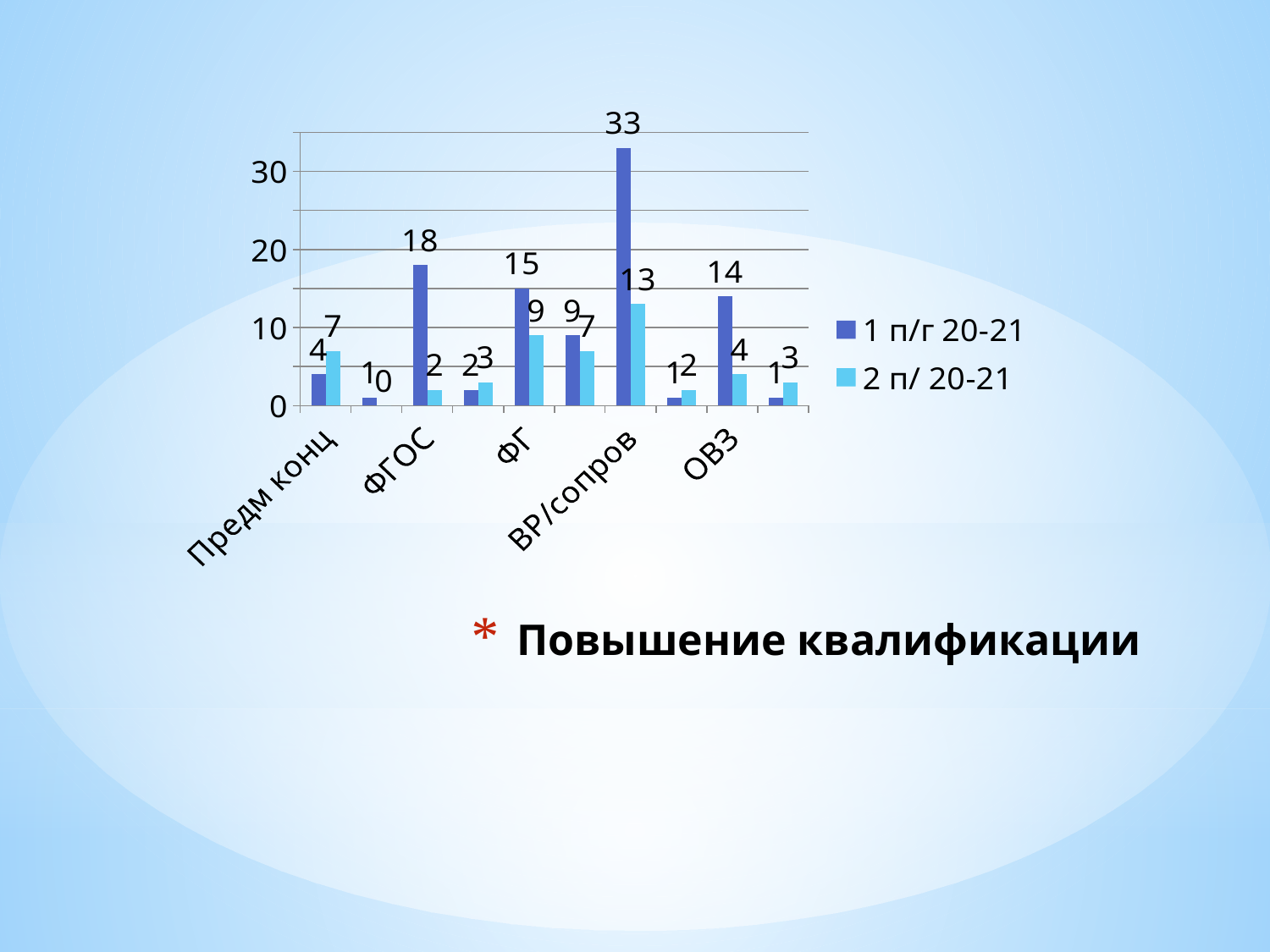
What kind of chart is shown on the slide? bar chart What is the value for ОВЗ in the 1 п/г 20-21 series? 14 What is the difference between the 1 п/г 20-21 and 2 п/ 20-21 values for ВР/сопров? 20 What is the value for ФГОС in the 2 п/ 20-21 series? 2 For Предм конц, which series has the larger value, 1 п/г 20-21 or 2 п/ 20-21? 2 п/ 20-21 What is the value for Предм конц in the 2 п/ 20-21 series? 7 Is the 1 п/г 20-21 value for ВР/сопров greater or less than 30? greater What is the value for ФГ in the 2 п/ 20-21 series? 9 Which labelled category has the highest value in the 1 п/г 20-21 series? ВР/сопров How many series does the legend list? 2 What is the value for ВР/сопров in the 1 п/г 20-21 series? 33 What is the difference between the 1 п/г 20-21 and 2 п/ 20-21 values for ФГОС? 16